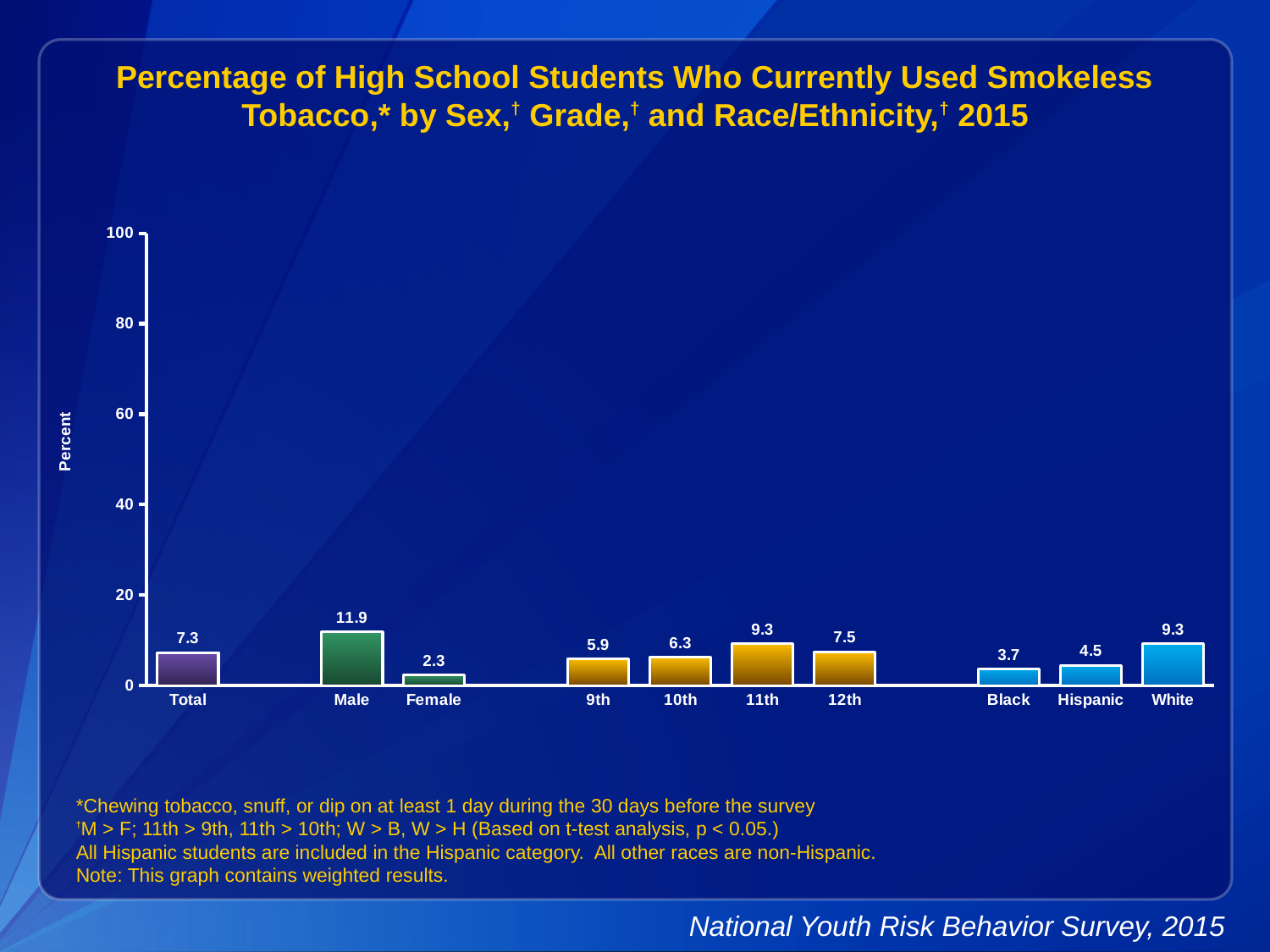
Is the value for Total greater or less than 20? less What kind of chart is this? bar chart How many categories are shown on the x axis? 10 Which is larger, the percentage for 9th grade or 12th grade? 12th What is the percentage for Female? 2.3 Which category has the lowest percentage? Female What is the label on the y axis? Percent What is the difference between the Male and Female percentages? 9.6 What is the percentage for 11th grade? 9.3 What is the percentage for Male? 11.9 Which category has the highest percentage? Male What is the percentage for Hispanic students? 4.5